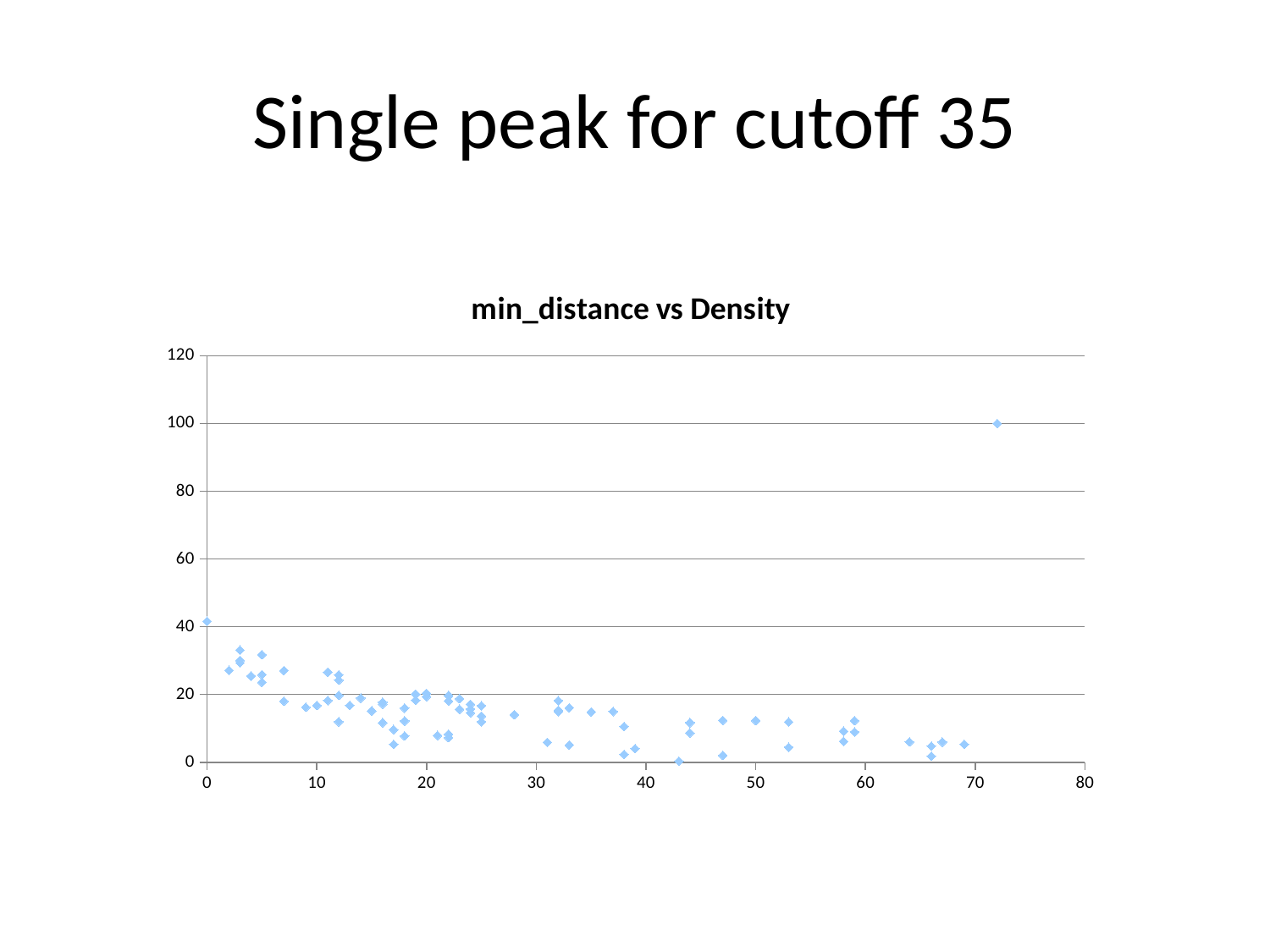
What kind of chart is shown on the slide? scatter chart Is the value of the point at x = 43 greater or less than 20? less Are most of the plotted points above or below 40 on the y axis? below What is the title of the chart? min_distance vs Density Is the value of the point at x = 0 greater or less than 20? greater How many points lie above 80 on the y axis? 1 Between x = 0 and x = 40, do the y values generally rise or fall as x increases? fall Is the point near x = 72 higher or lower than the point at x = 0? higher What is the highest value shown on the y axis? 120